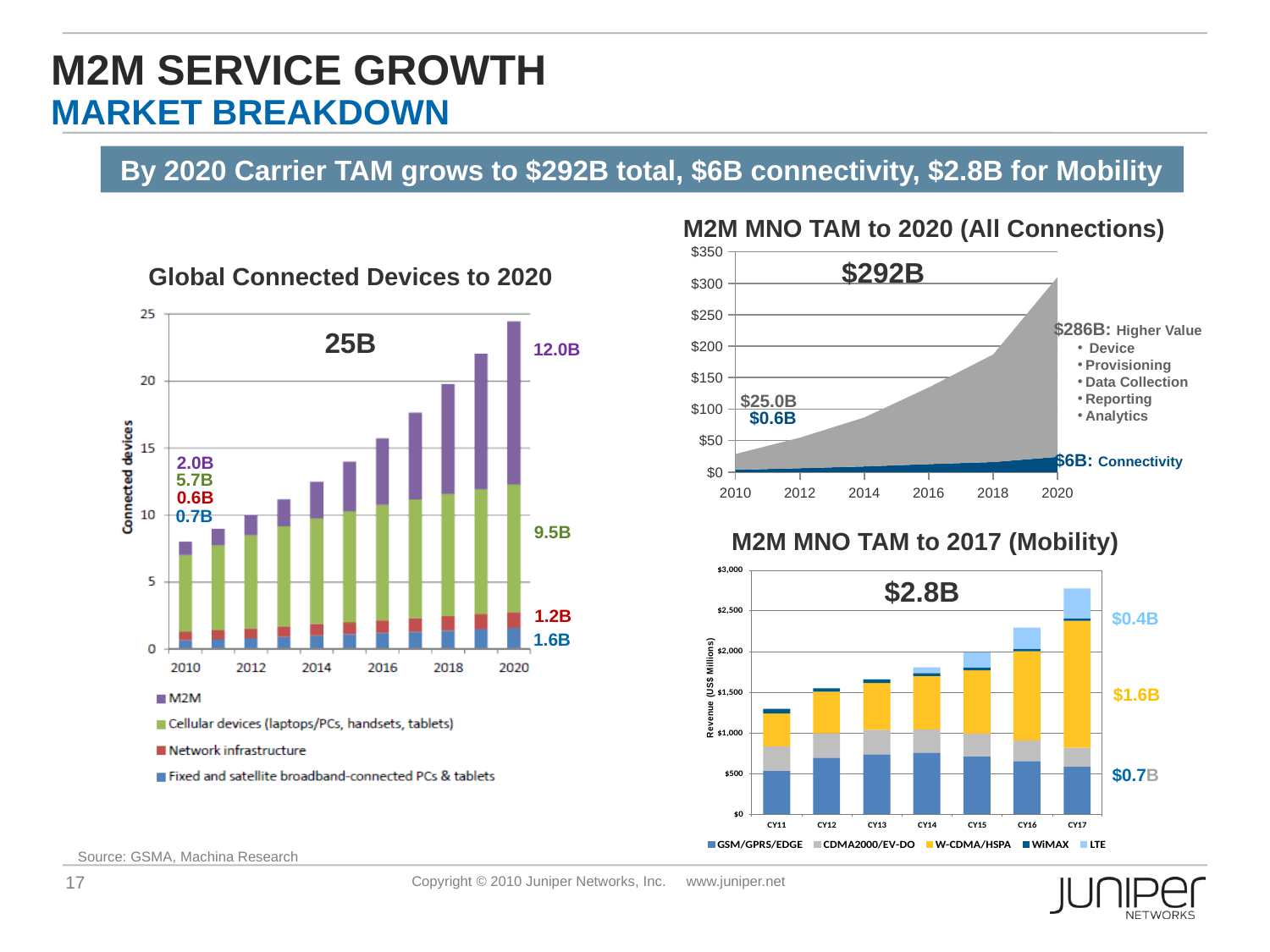
On the M2M MNO TAM to 2020 (All Connections) chart, what is the difference between the Higher Value ($286B) and Connectivity ($6B) amounts? $280B On the M2M MNO TAM to 2017 (Mobility) chart, is the total for CY11 greater or less than $1,500? less On the Global Connected Devices to 2020 chart, is the total for 2010 greater or less than 10? less On the Global Connected Devices to 2020 chart, which is larger in 2020: M2M or Cellular devices? M2M On the Global Connected Devices to 2020 chart, what total is labelled for 2020? 25B On the Global Connected Devices to 2020 chart, what is the value labelled for M2M in 2020? 12.0B On the M2M MNO TAM to 2020 (All Connections) chart, what total is labelled for 2020? $292B On the Global Connected Devices to 2020 chart, what is the value labelled for Cellular devices in 2010? 5.7B On the M2M MNO TAM to 2020 (All Connections) chart, what value is labelled for Connectivity? $6B On the M2M MNO TAM to 2017 (Mobility) chart, how many series does the legend list? 5 On the Global Connected Devices to 2020 chart, how many series does the legend list? 4 On the Global Connected Devices to 2020 chart, by how much does the M2M value grow from 2010 (2.0B) to 2020 (12.0B)? 10.0B